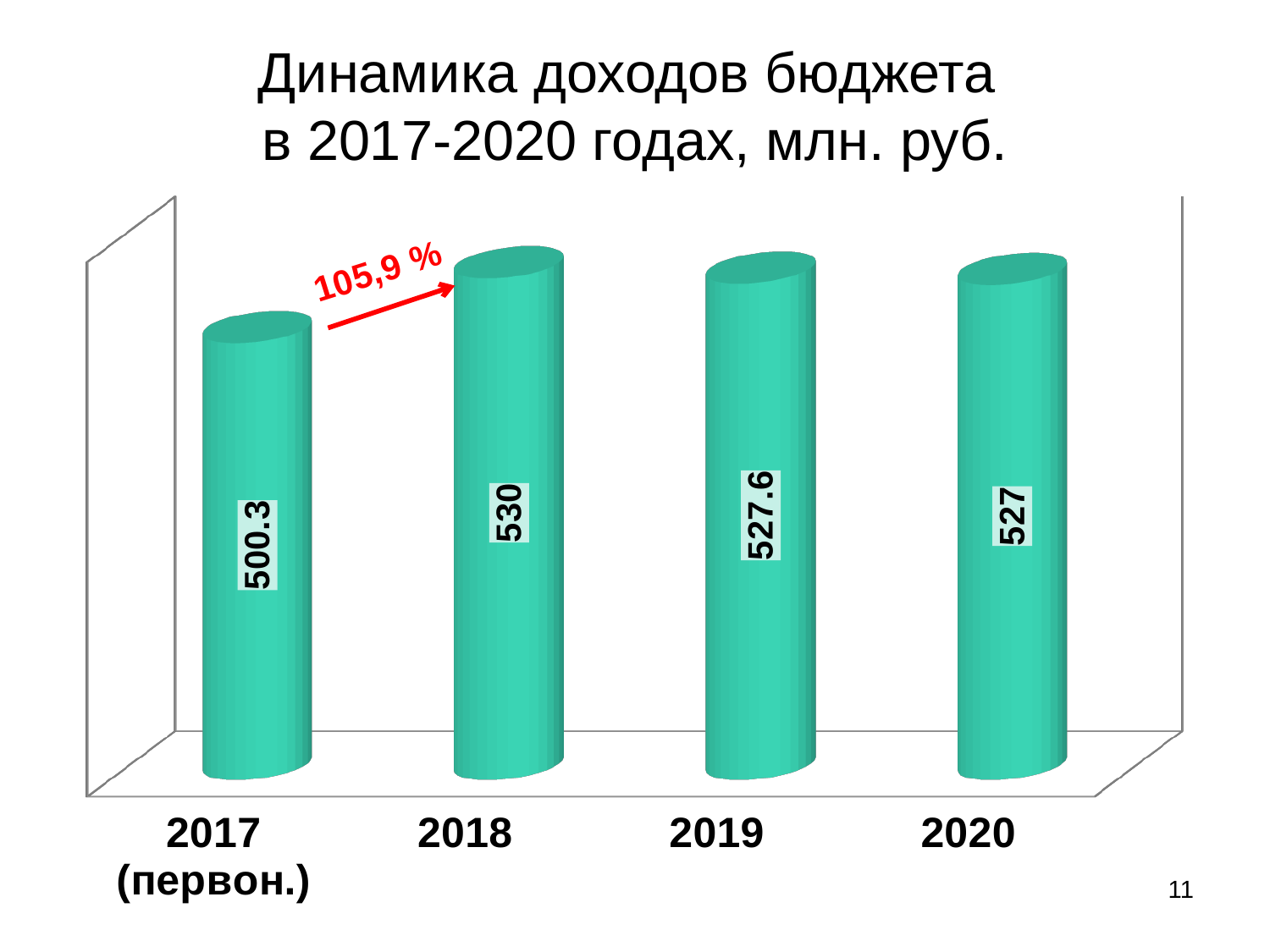
What is the value for 2018? 530 What kind of chart is this? bar chart What is the difference between the values for 2018 and 2017 (первон.)? 29.7 What is the difference between the values for 2019 and 2020? 0.6 What is the value for 2019? 527.6 Which year has the highest value? 2018 What percentage is written next to the red arrow between 2017 and 2018? 105,9 % How many years are shown on the chart? 4 What is the value for 2020? 527 Which year has the lowest value? 2017 (первон.) What is the value for 2017 (первон.)? 500.3 Which is larger, the value for 2018 or the value for 2017 (первон.)? 2018